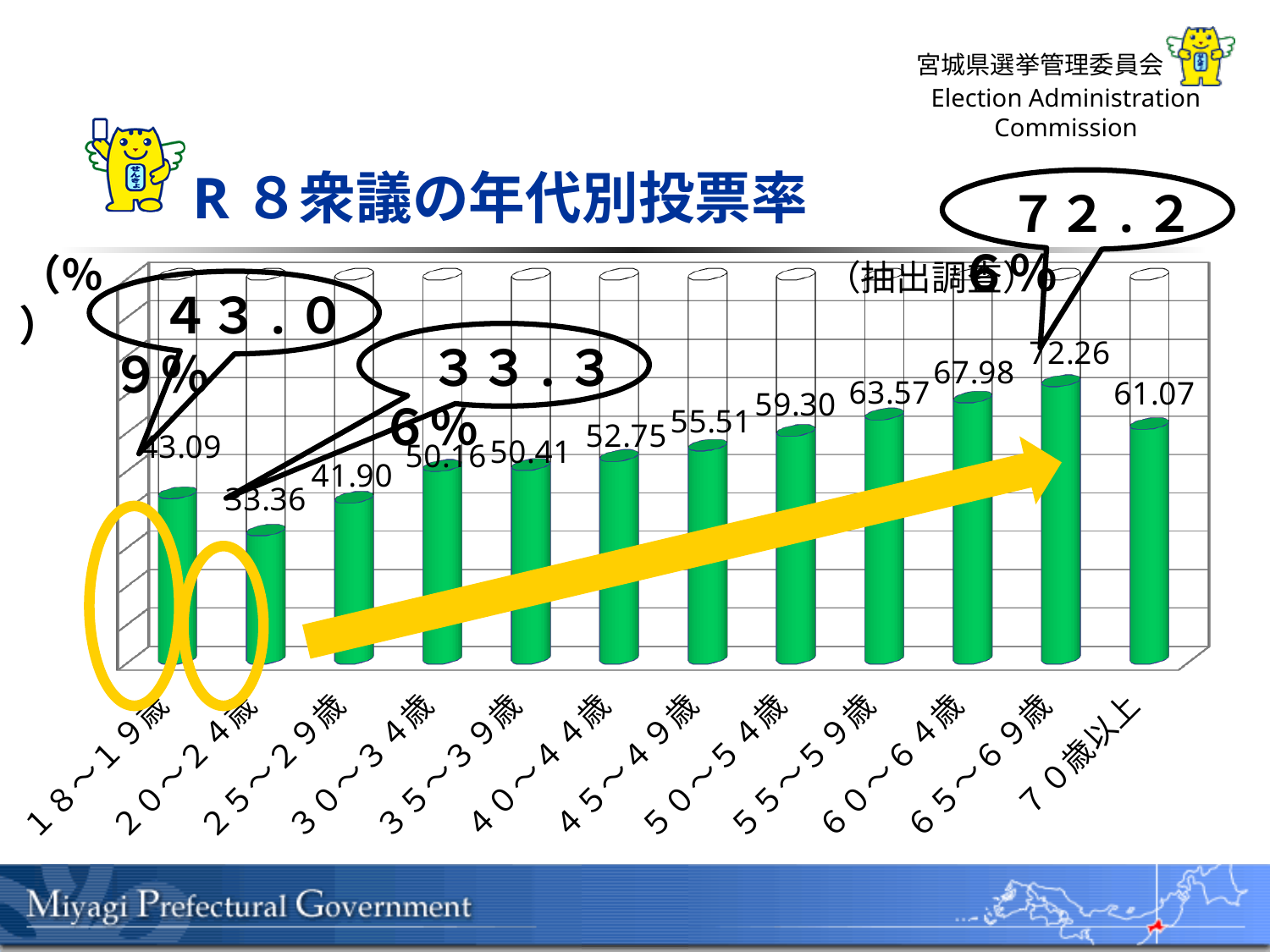
From 20～24歳 through 65～69歳, do the values rise or fall along the x axis? Rise Which age group has the highest turnout in the chart? 65～69歳 What is the value shown for the 70歳以上 age group? 61.07 What is the voter turnout value shown for the 18～19歳 age group? 43.09 What kind of chart is shown on the slide? Bar chart Which age group has the lowest turnout in the chart? 20～24歳 What is the difference between the values for 65～69歳 and 20～24歳? 38.90 What is the title of the chart on the slide? R８衆議の年代別投票率 Which has the larger value, 18～19歳 or 25～29歳? 18～19歳 What is the value shown for the 65～69歳 age group? 72.26 What is the value shown for the 40～44歳 age group? 52.75 How many age-group categories are plotted in the chart? 12